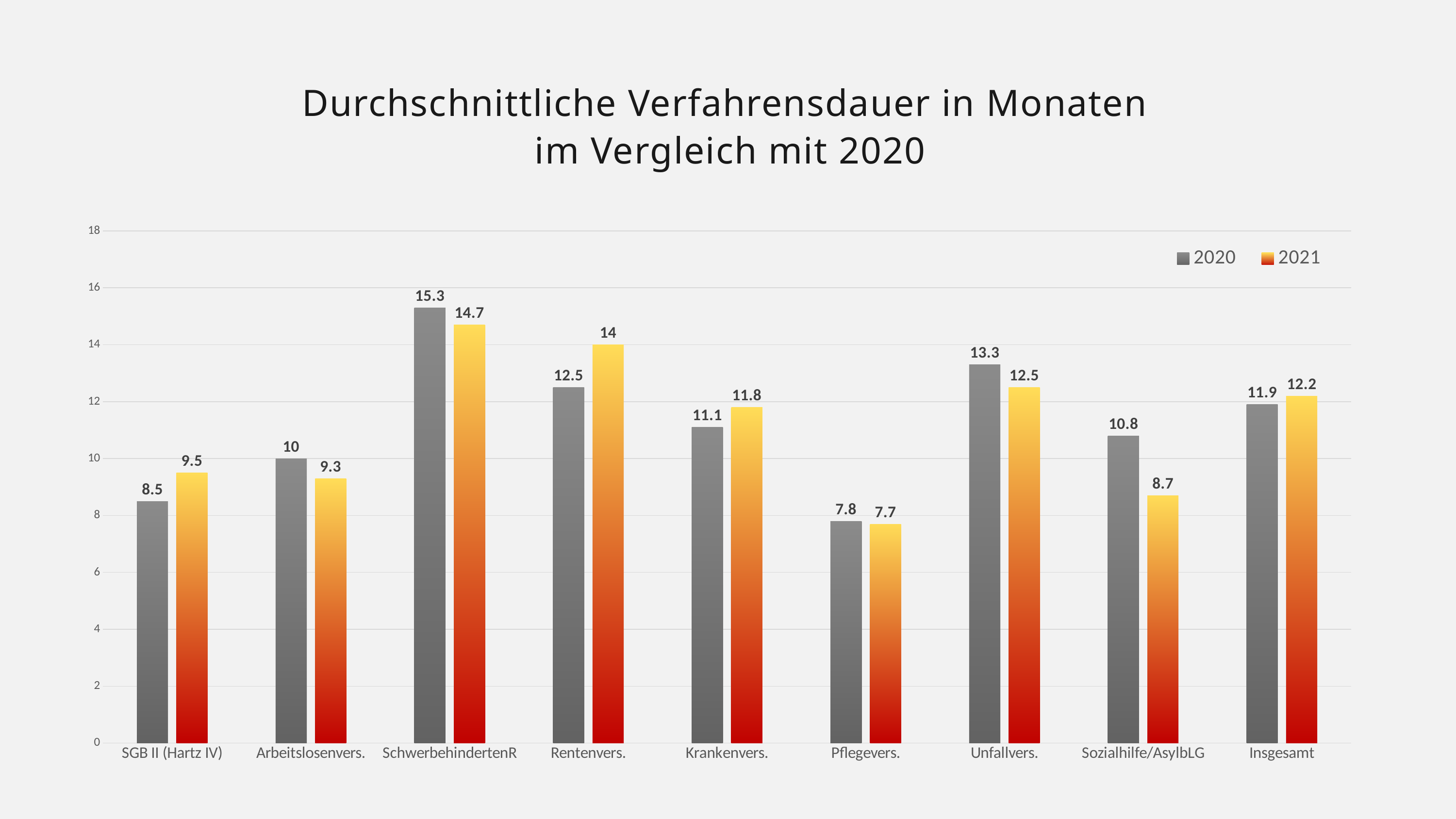
What is the 2020 value for Sozialhilfe/AsylbLG? 10.8 What kind of chart is shown on the slide? bar chart Which category has the highest 2020 value? SchwerbehindertenR What is the difference between the 2020 and 2021 values for Sozialhilfe/AsylbLG? 2.1 How many categories are shown on the x axis? 9 How many series does the legend list? 2 Is the 2021 value for SchwerbehindertenR greater or less than 14? greater Which is larger for Unfallvers., the 2020 value or the 2021 value? 2020 What is the title of the chart? Durchschnittliche Verfahrensdauer in Monaten im Vergleich mit 2020 Which category has the lowest 2021 value? Pflegevers. What is the 2021 value for Rentenvers.? 14 What is the 2021 value for Insgesamt? 12.2